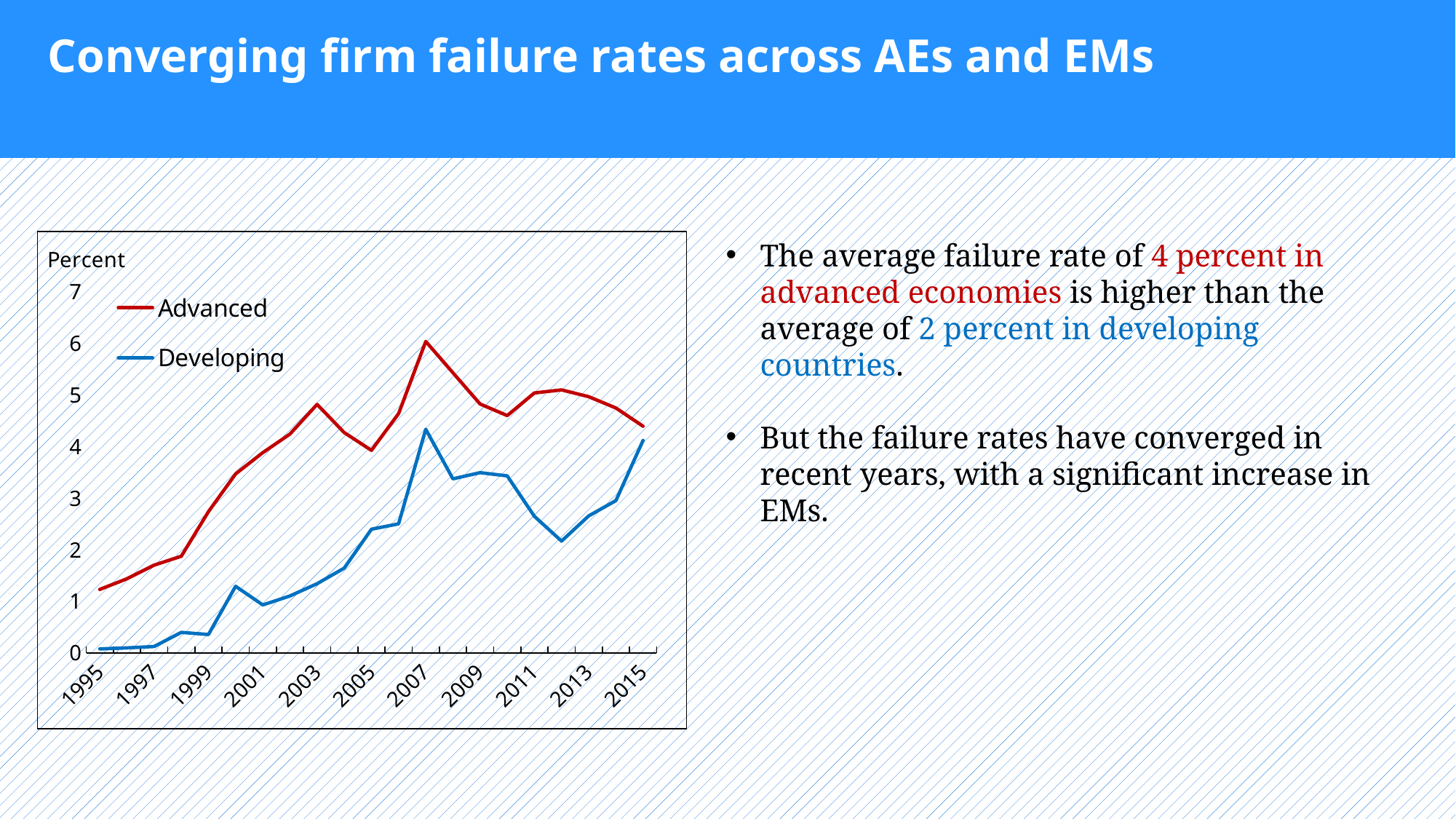
What unit is shown on the chart's vertical axis? Percent How many series does the chart's legend list? 2 Is the value for Developing in 2012 greater or less than 3? less In 2005, which series has the higher value, Advanced or Developing? Advanced Is the value for Developing in 1995 greater or less than 1? less Is the value for Advanced in 2007 greater or less than 5? greater What are the two series named in the chart's legend? Advanced and Developing In which year is the Developing series at its lowest value? 1995 In which year does the Advanced series reach its highest value? 2007 What kind of chart is shown on the slide? Line chart Does the Developing series generally rise or fall between 1995 and 2007? Rise